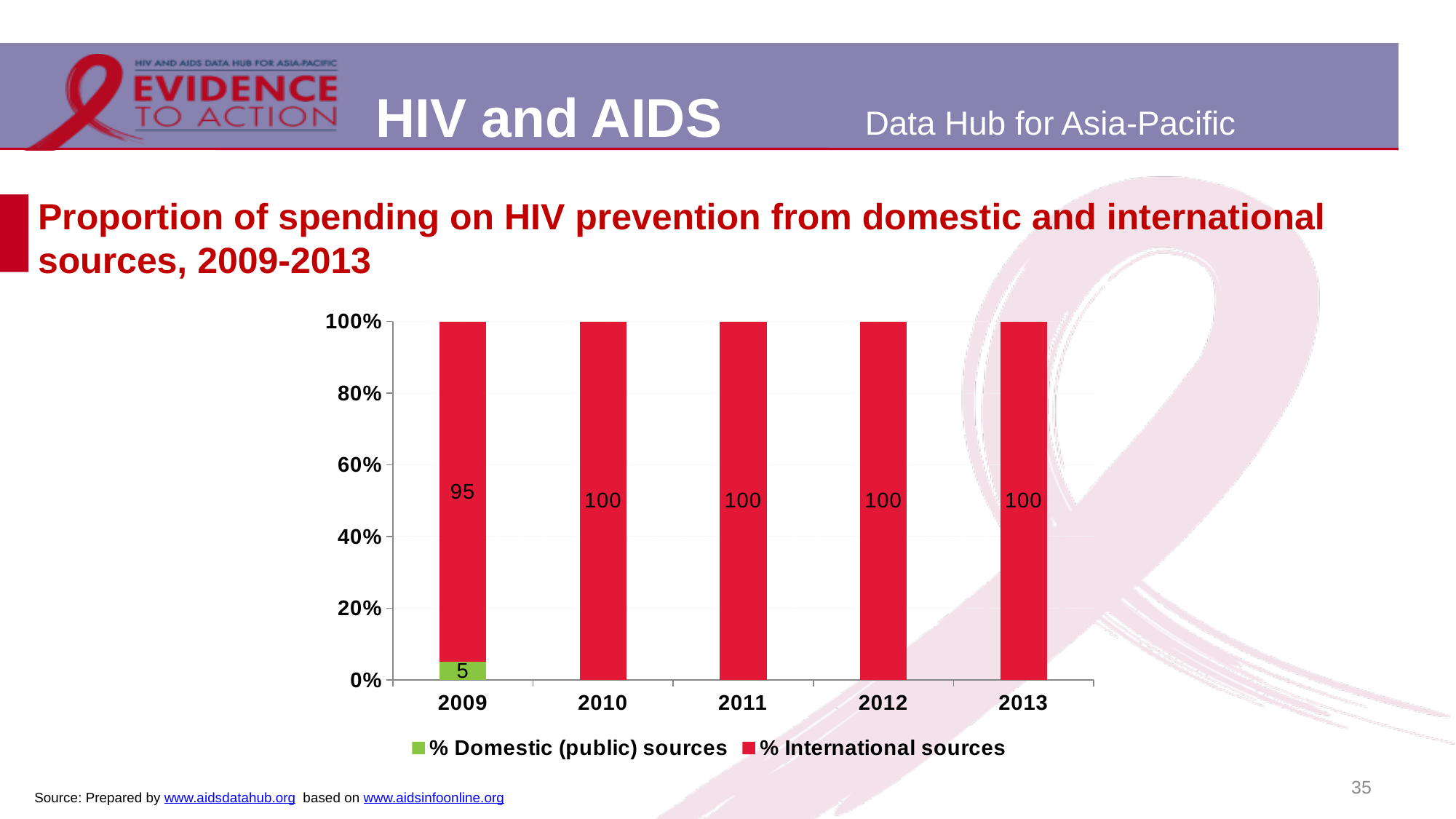
Is the value for % International sources in 2009 greater or less than 80%? greater What is the difference between the % International sources value in 2010 and in 2009? 5 How many series does the legend list? 2 What is the value for % International sources in 2009? 95 What kind of chart is shown on the slide? Stacked bar chart What is the total of the stacked bar for 2009? 100 In which year is the % International sources value lowest? 2009 What is the value for % International sources in 2012? 100 Which is larger in 2009: % Domestic (public) sources or % International sources? % International sources What is the value for % Domestic (public) sources in 2009? 5 Which colour represents % Domestic (public) sources in the chart? Green How many years are shown on the x axis? 5